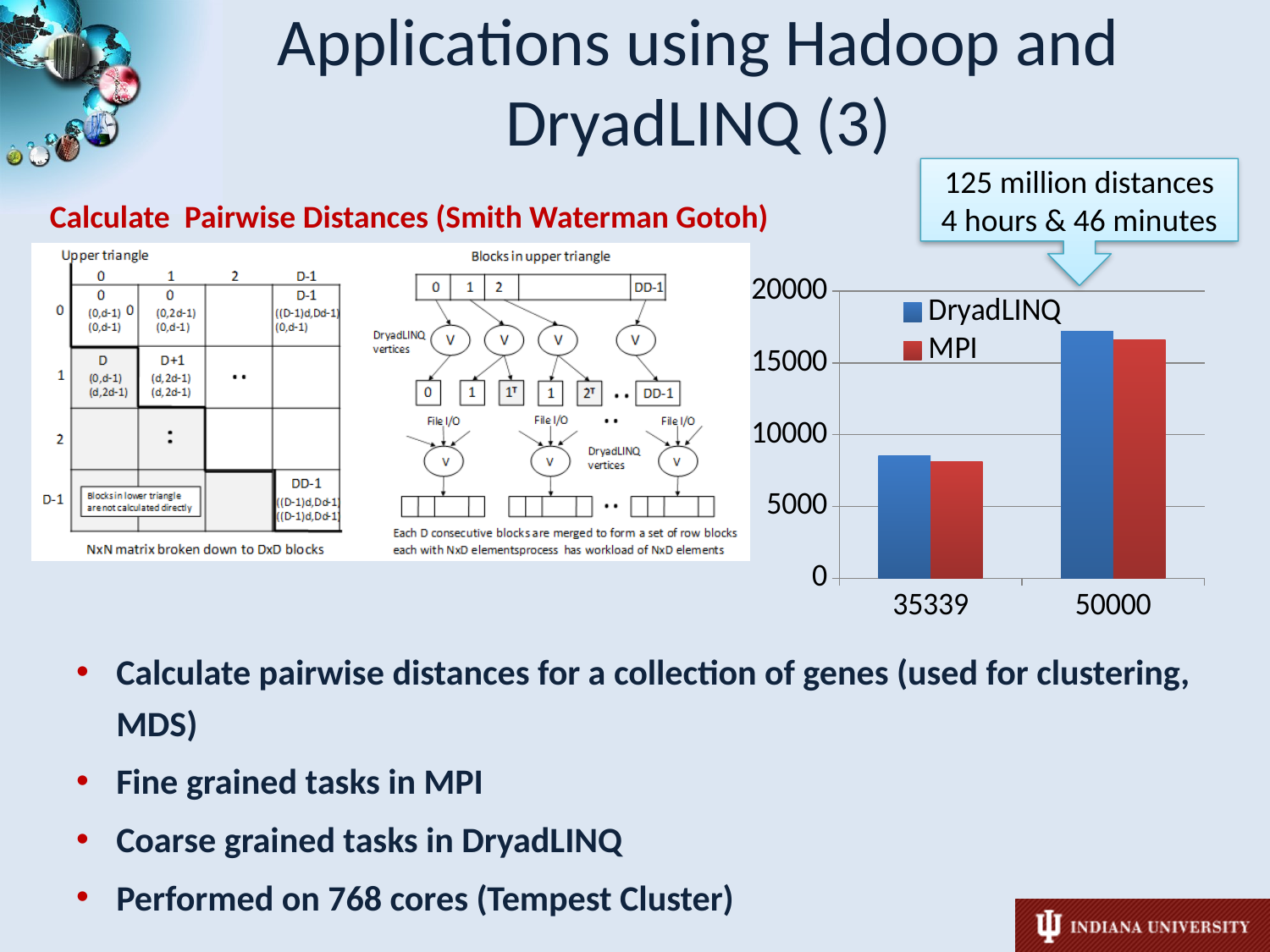
Do the MPI values rise or fall from 35339 to 50000? rise How many categories are shown on the x axis of the bar chart? 2 Which colour represents MPI in the bar chart? red What kind of chart is shown on the right side of the slide? bar chart Is the DryadLINQ value for 35339 greater or less than 10000? less Is the DryadLINQ value for 35339 greater or less than 5000? greater Is the DryadLINQ value for 50000 greater or less than 15000? greater For which category is the DryadLINQ bar highest? 50000 How many series does the legend of the bar chart list? 2 What are the two series named in the bar chart legend? DryadLINQ and MPI